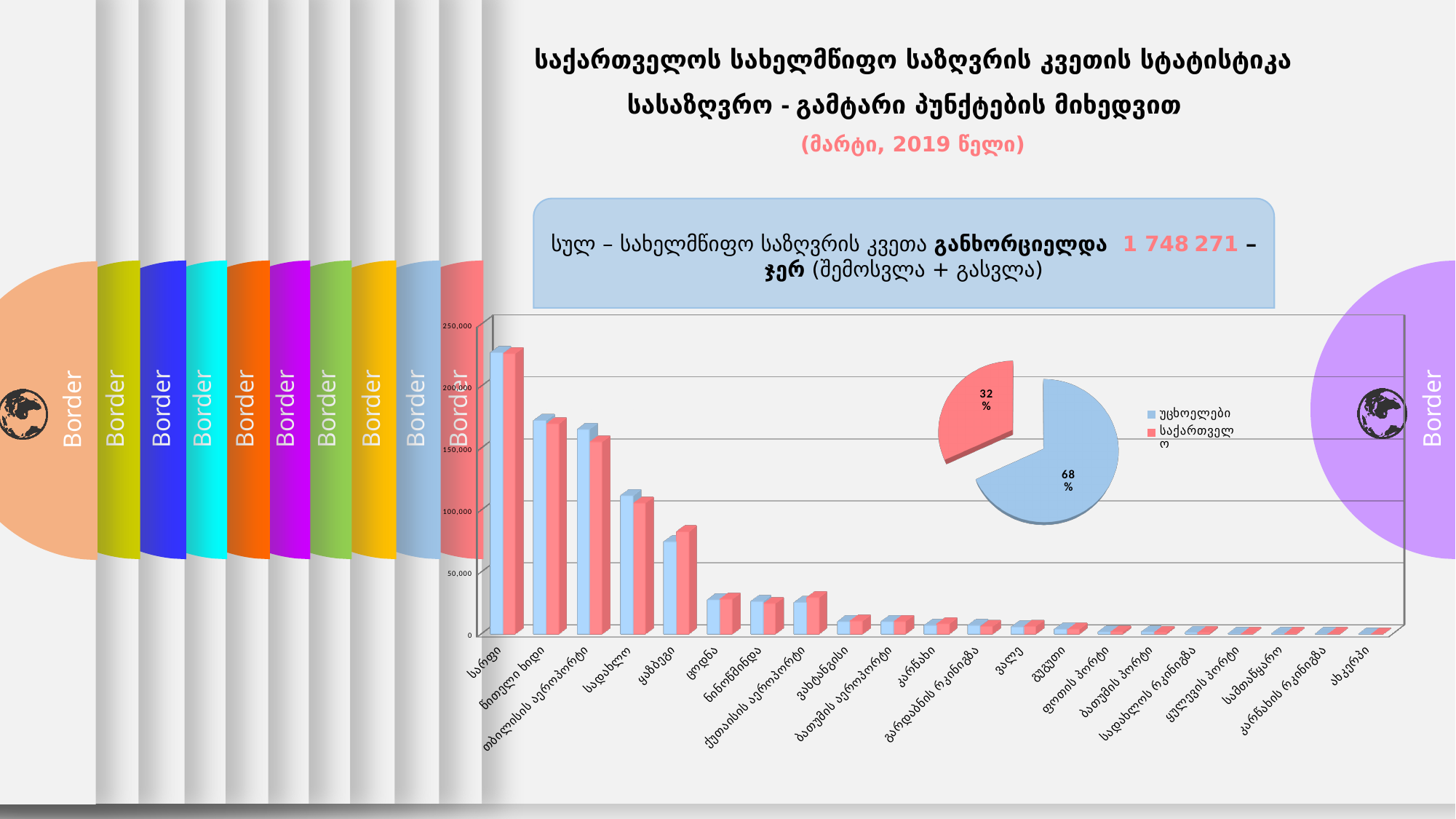
In the bar chart, is the value for სარფი greater or less than 200,000? greater In the pie chart, what share is shown for საქართველო? 32% In the pie chart, what share is shown for უცხოელები? 68% How many categories are shown on the x axis of the bar chart? 21 What kind of chart is the chart on the right with the 32% and 68% labels? Pie chart In the bar chart, do the values generally rise or fall from left to right along the x axis? fall How many entries does the pie chart's legend list? 2 In the bar chart, is the value for სადახლო greater or less than 150,000? less What kind of chart is the large chart at the bottom of the slide? Bar chart In the bar chart, is the value for ყაზბეგი greater or less than 100,000? less In the bar chart, which category has the highest values? სარფი In the pie chart, which slice is larger, უცხოელები or საქართველო? უცხოელები